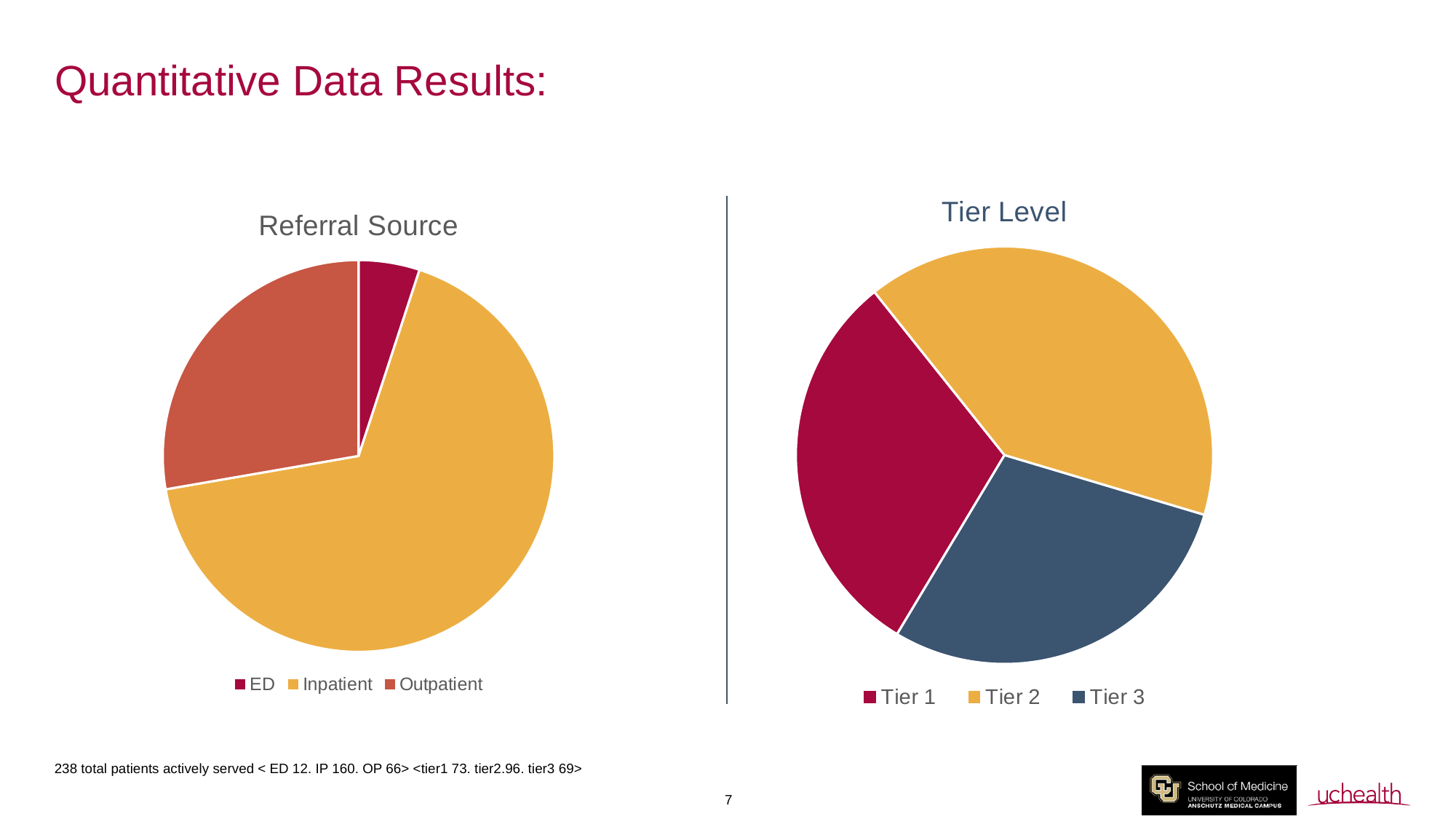
In the Referral Source chart, which slice is larger, Inpatient or Outpatient? Inpatient What is the title of the pie chart on the left side of the slide? Referral Source What colour is the Tier 3 slice in the Tier Level chart? dark blue In the Tier Level chart, which slice is larger, Tier 2 or Tier 3? Tier 2 What type of chart is the Tier Level chart? pie chart How many entries does the legend of the Tier Level chart list? 3 In the Referral Source chart, which slice is larger, Outpatient or ED? Outpatient How many categories does the Referral Source chart show? 3 In the Tier Level chart, which tier has the largest slice? Tier 2 In the Referral Source chart, which referral source has the smallest slice? ED In the Referral Source chart, which referral source has the largest slice? Inpatient What type of chart is the Referral Source chart? pie chart